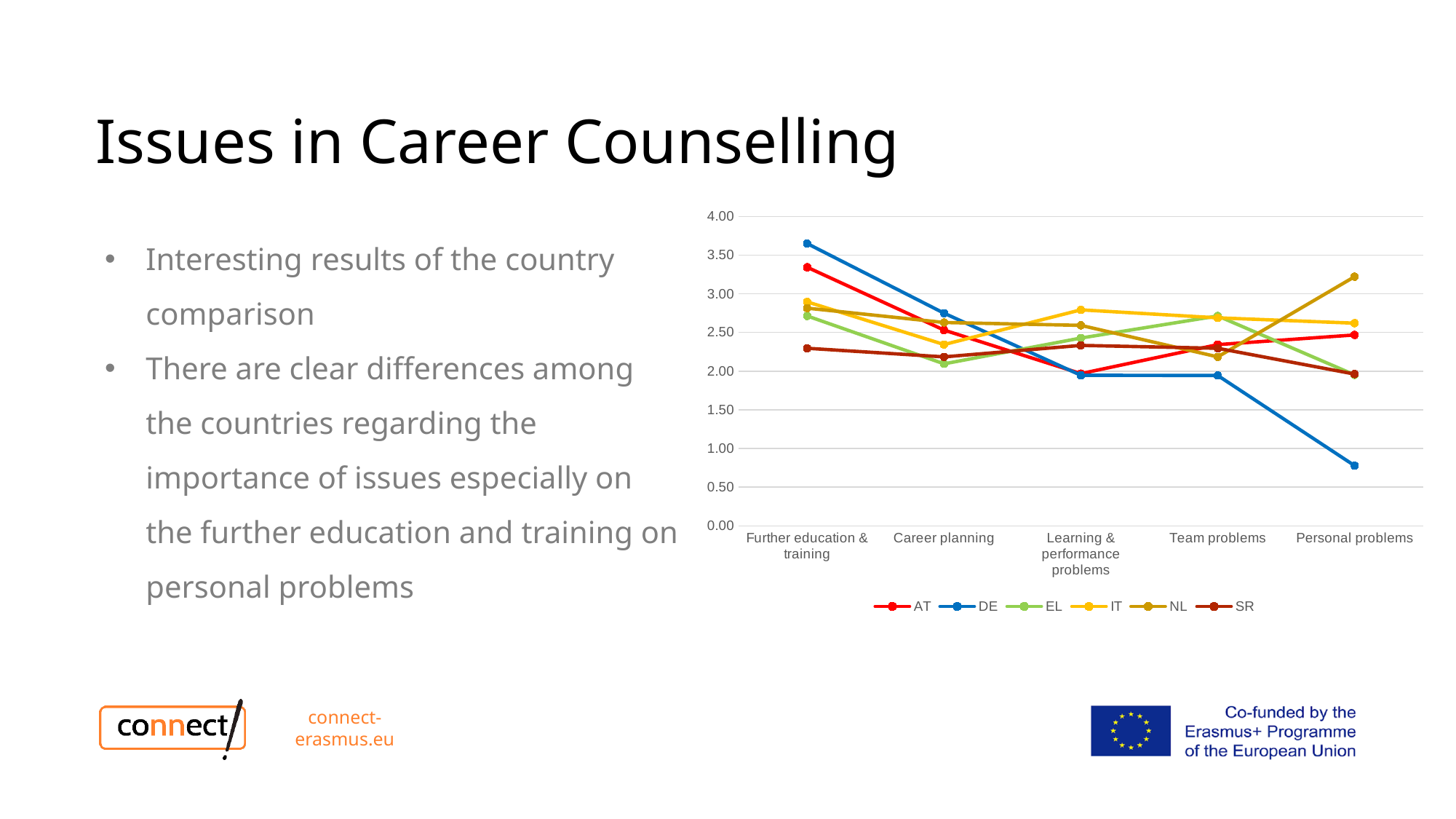
How many categories are shown along the x axis of the chart? 5 What kind of chart is shown on the slide? line chart Is the value for DE at Further education & training greater or less than 3.50? greater Does the DE line generally rise or fall from Further education & training to Personal problems? fall Which country has the highest value for Further education & training? DE Is the value for DE at Personal problems greater or less than 1.00? less Which country has the lowest value for Personal problems? DE Is the value for NL at Personal problems greater or less than 3.00? greater How many series does the chart's legend list? 6 Which is larger at Further education & training, the value for AT or the value for SR? AT Which country has the highest value for Personal problems? NL What colour is the line for DE in the chart? blue